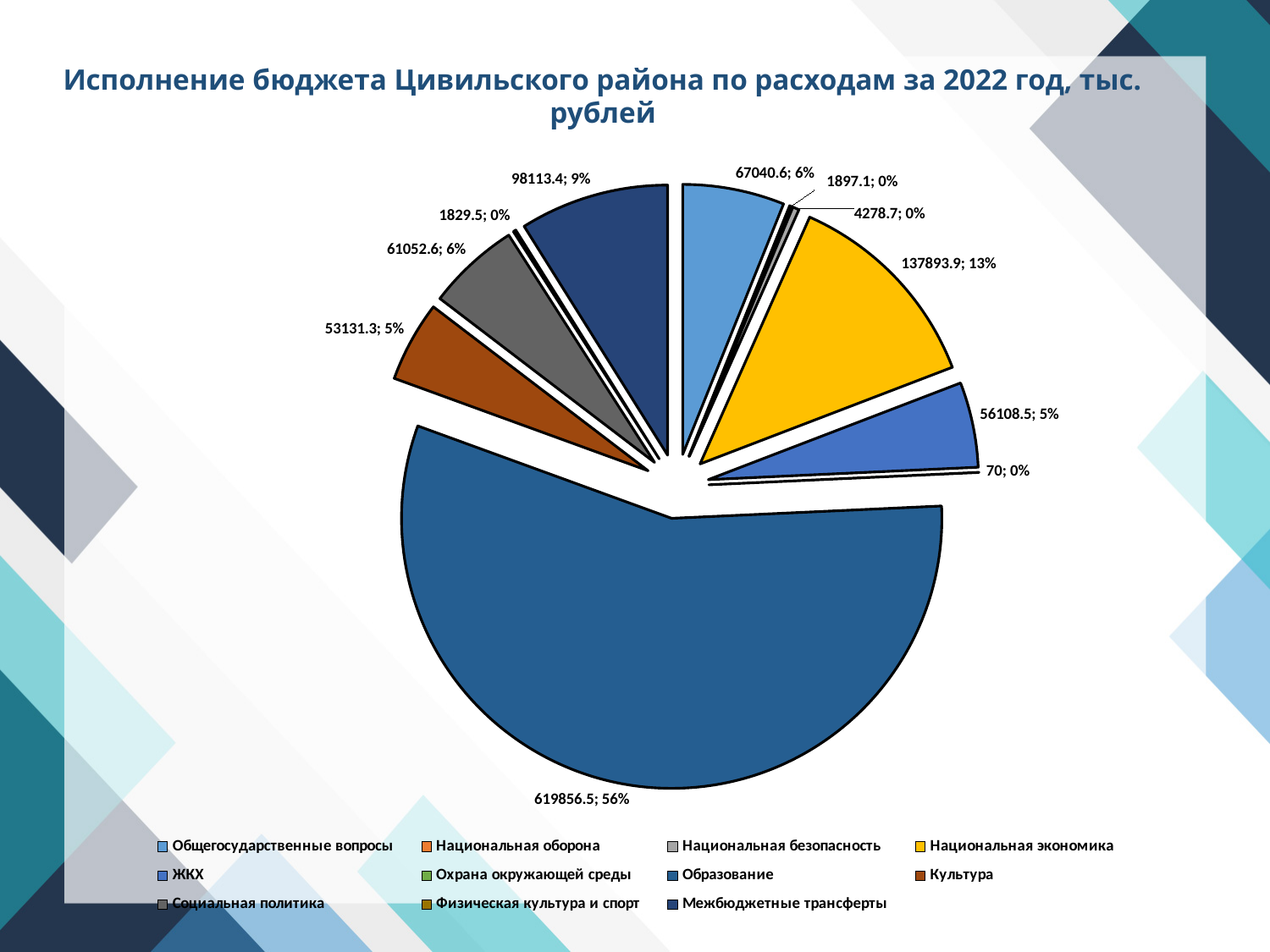
Which is larger, the value for Образование or the value for Национальная экономика? Образование Which category has the largest slice in the pie chart? Образование What share of the pie does Межбюджетные трансферты account for? 9% What is the title of the chart? Исполнение бюджета Цивильского района по расходам за 2022 год, тыс. рублей What value is shown for Национальная экономика? 137893.9 What is the difference between the values for Образование and Национальная экономика? 481962.6 What value is shown for Образование? 619856.5 What is the difference between the values for Национальная экономика and Межбюджетные трансферты? 39780.5 What share of the pie does Образование account for? 56% What kind of chart is shown on the slide? pie chart How many slices does the pie chart have? 11 How many categories does the legend of the pie chart list? 11